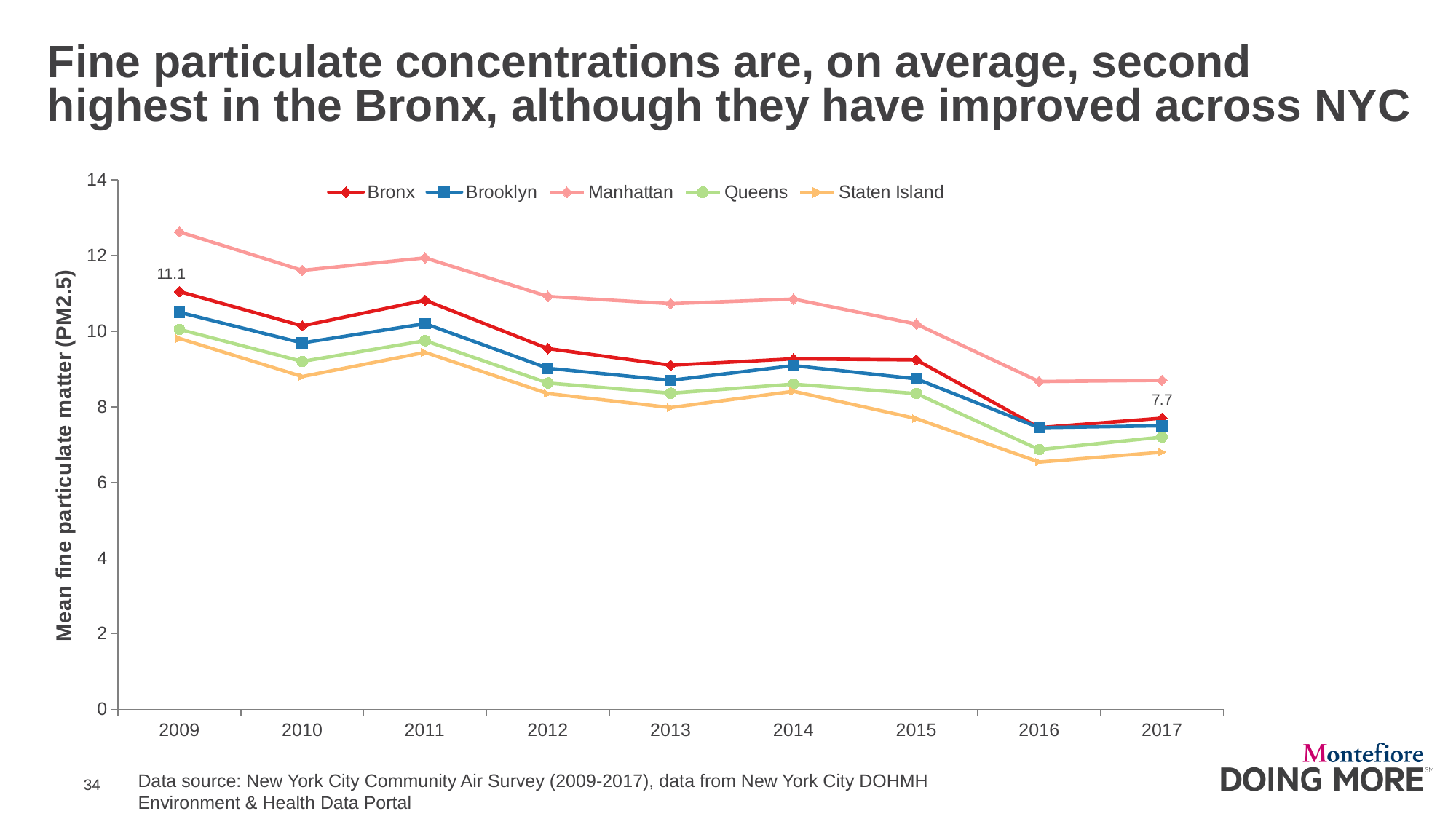
What is the value for the Bronx in 2017? 7.7 Is the value for Staten Island in 2016 greater or less than 7? less How many series does the legend list? 5 What kind of chart is shown on the slide? line chart How many years are shown along the x axis? 9 Which borough has the lowest value in 2017? Staten Island By how much did the Bronx value fall from 2009 to 2017? 3.4 What is the value for the Bronx in 2009? 11.1 Does the Manhattan line rise or fall from 2009 to 2017? fall What is the title of the y axis? Mean fine particulate matter (PM2.5) Which borough has the highest value in 2009? Manhattan Is the value for Manhattan in 2009 greater or less than 12? greater